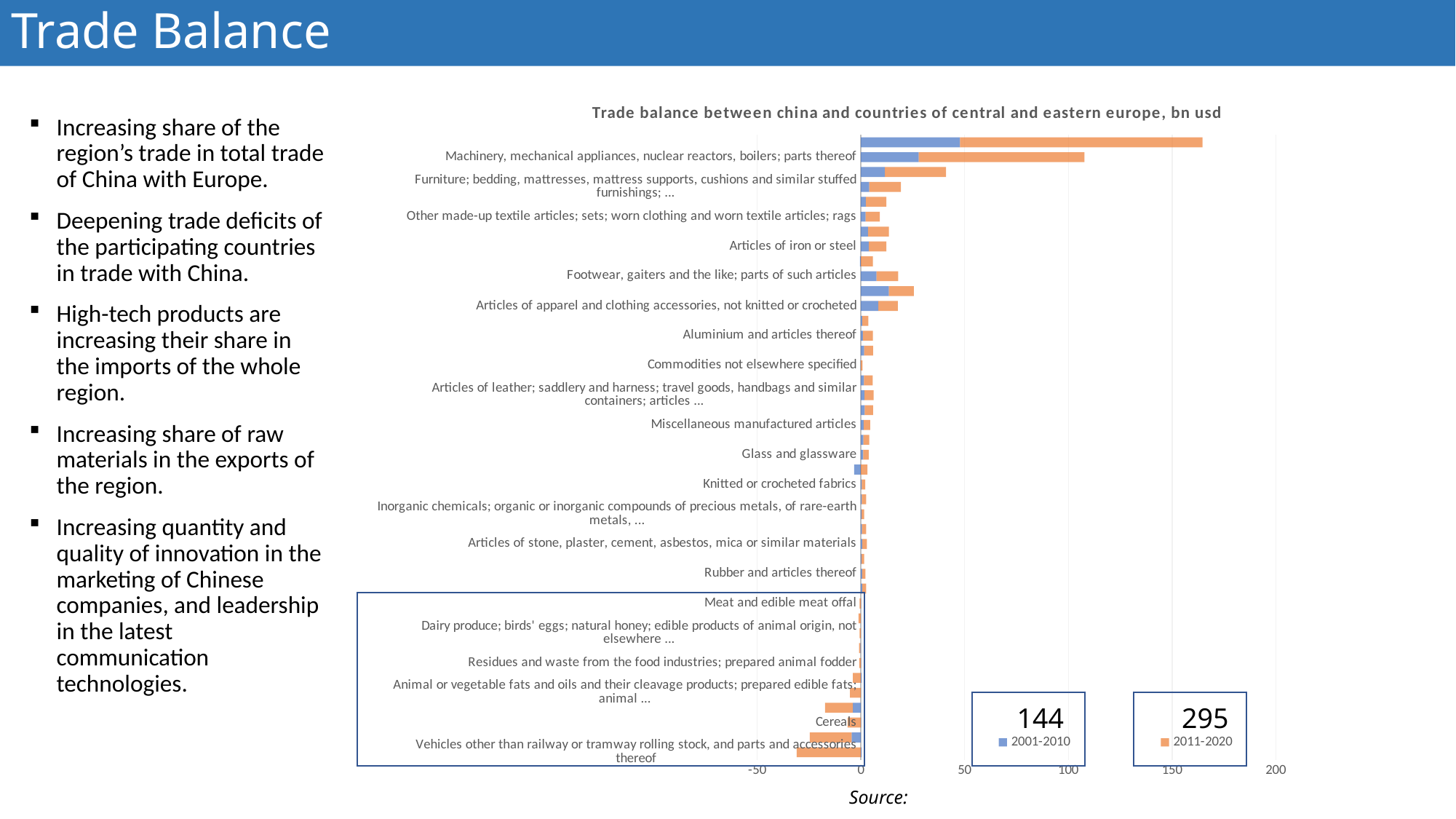
Do the bar lengths generally increase or decrease going from the top of the chart to the bottom? decrease What are the two series named in the legend? 2001-2010 and 2011-2020 Is the 2011-2020 value for Machinery, mechanical appliances, nuclear reactors, boilers; parts thereof greater or less than 50? greater Is the 2011-2020 value for Vehicles other than railway or tramway rolling stock, and parts and accessories thereof greater or less than 0? less What is the difference between the numbers shown in the two legend boxes (295 and 144)? 151 How many series does the chart's legend list? 2 What number is printed in the box above the 2011-2020 legend entry? 295 What is the title of the chart? Trade balance between china and countries of central and eastern europe, bn usd Which legend box shows the larger number, 2001-2010 or 2011-2020? 2011-2020 What is the highest value shown on the horizontal axis? 200 What number is printed in the box above the 2001-2010 legend entry? 144 What kind of chart is shown on the slide? bar chart